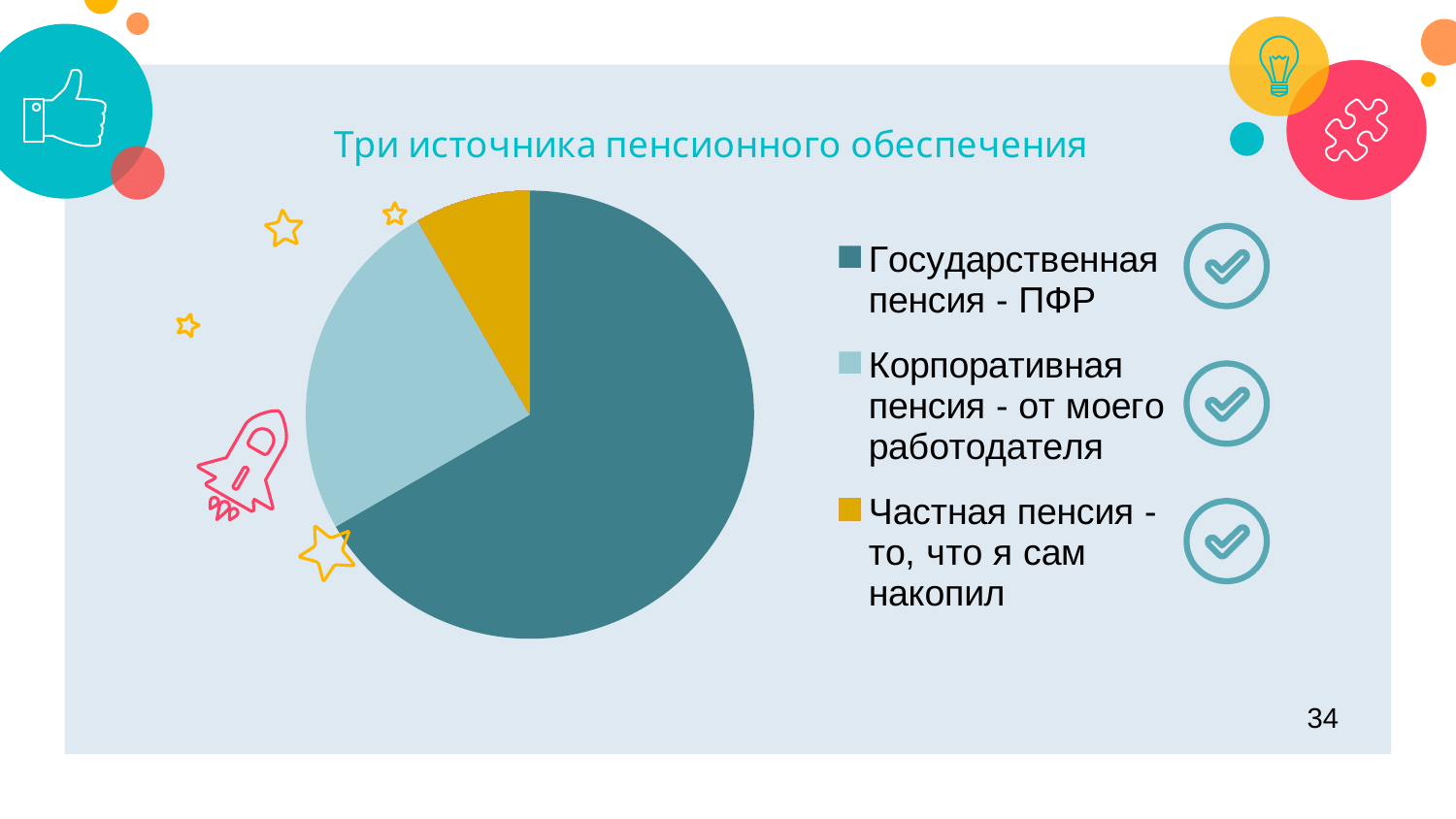
How many slices does the pie chart have? 3 What is the title of the chart on the slide? Три источника пенсионного обеспечения What colour is the slice for Частная пенсия - то, что я сам накопил? Yellow Which slice is larger: Корпоративная пенсия - от моего работодателя or Частная пенсия - то, что я сам накопил? Корпоративная пенсия - от моего работодателя What kind of chart is shown on the slide? Pie chart Which slice is larger: Государственная пенсия - ПФР or Корпоративная пенсия - от моего работодателя? Государственная пенсия - ПФР Which category has the smallest slice of the pie chart? Частная пенсия - то, что я сам накопил Which category has the largest slice of the pie chart? Государственная пенсия - ПФР Does the slice for Государственная пенсия - ПФР take up more or less than half of the pie? More